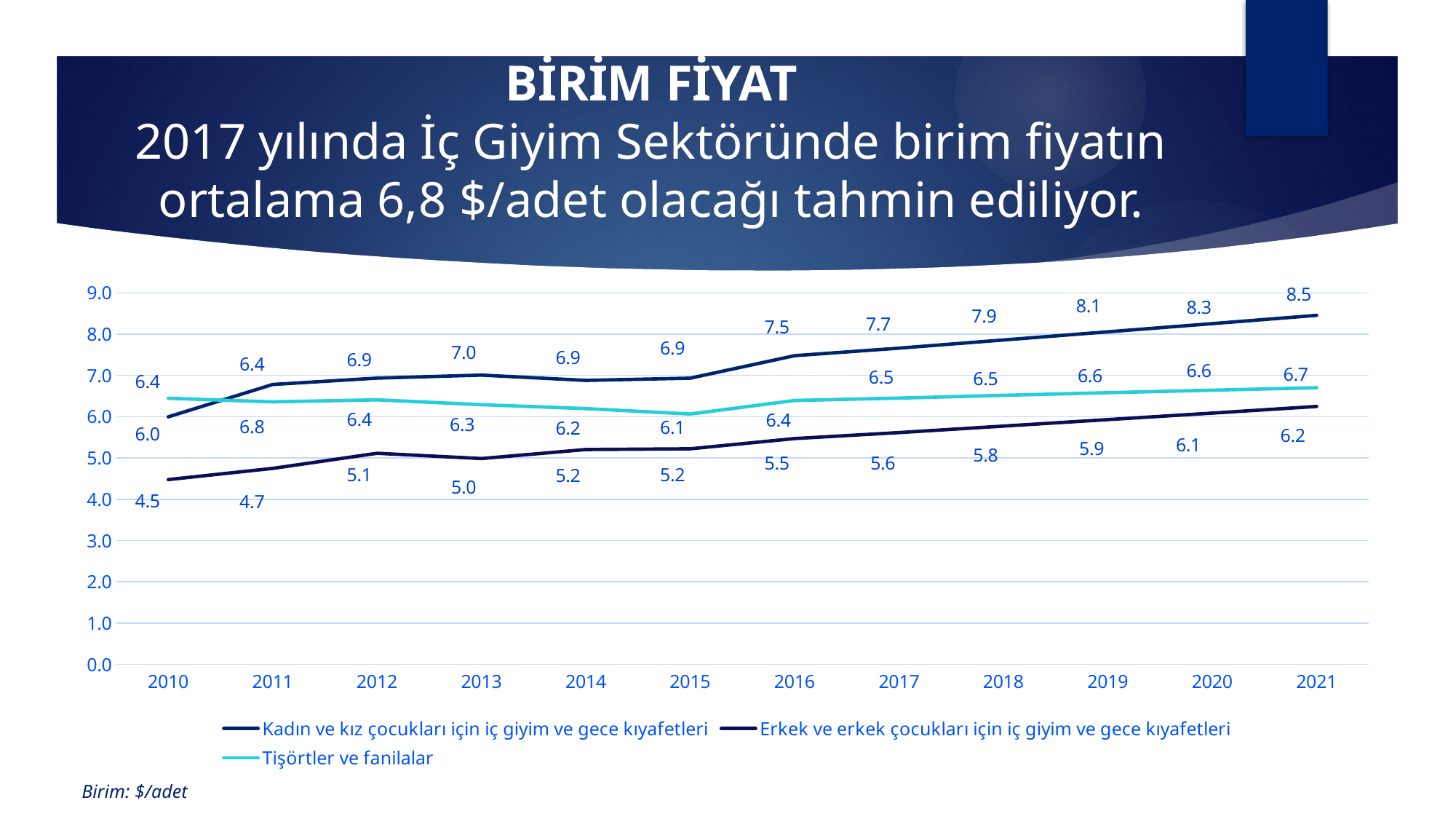
How many series does the legend list? 3 What is the value for 'Tişörtler ve fanilalar' in 2017? 6.5 What is the difference between the 2021 values of 'Kadın ve kız çocukları için iç giyim ve gece kıyafetleri' and 'Erkek ve erkek çocukları için iç giyim ve gece kıyafetleri'? 2.3 What is the value for 'Kadın ve kız çocukları için iç giyim ve gece kıyafetleri' in 2021? 8.5 How many years are shown on the x axis? 12 Does the value for 'Erkek ve erkek çocukları için iç giyim ve gece kıyafetleri' generally rise or fall from 2010 to 2021? rise In which year is the value for 'Erkek ve erkek çocukları için iç giyim ve gece kıyafetleri' lowest? 2010 What is the value for 'Erkek ve erkek çocukları için iç giyim ve gece kıyafetleri' in 2010? 4.5 What unit is stated below the chart? $/adet In which year is the value for 'Kadın ve kız çocukları için iç giyim ve gece kıyafetleri' highest? 2021 In 2010, which is larger: 'Tişörtler ve fanilalar' or 'Kadın ve kız çocukları için iç giyim ve gece kıyafetleri'? Tişörtler ve fanilalar What type of chart is shown on the slide? line chart